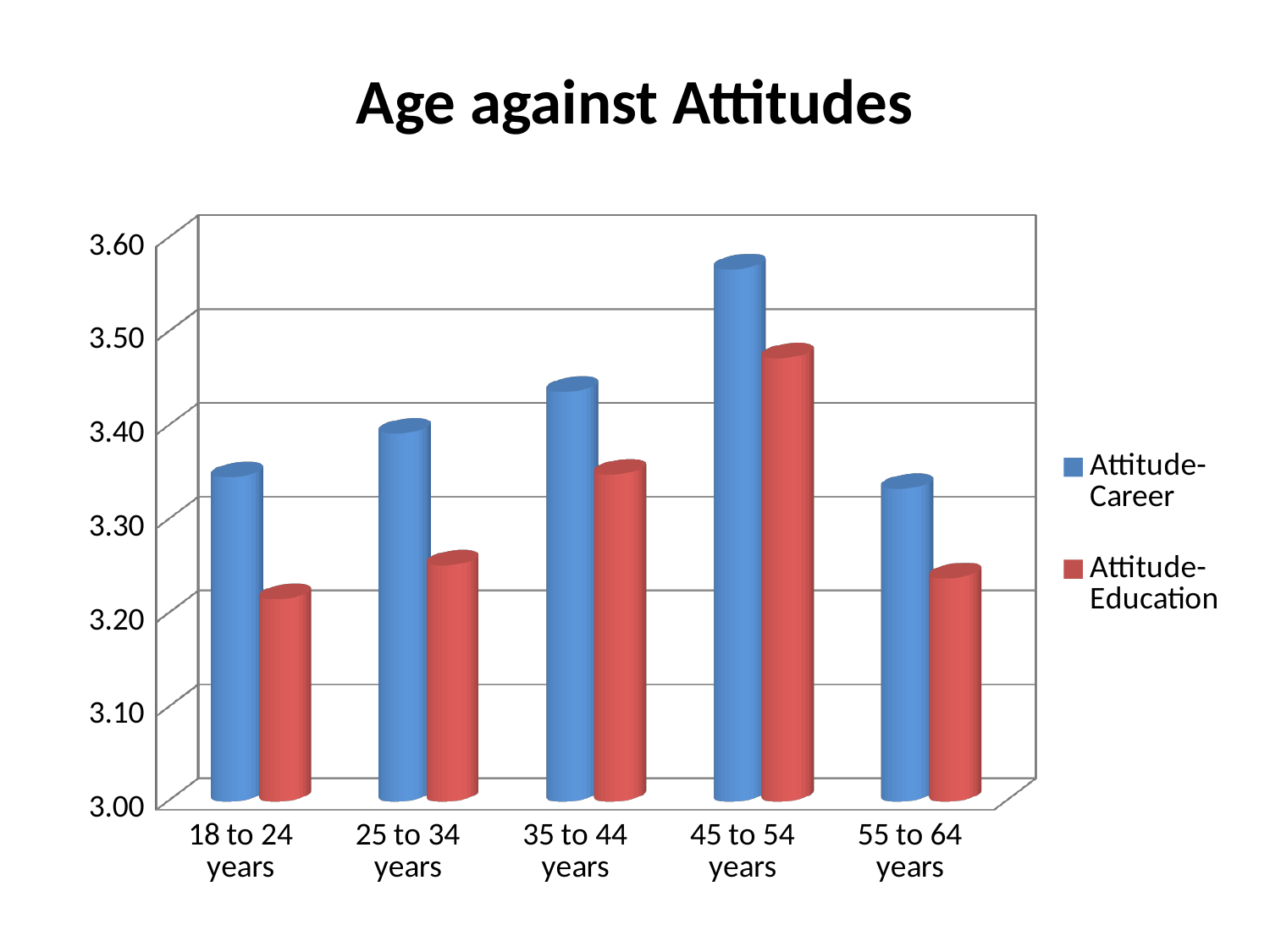
How many series does the legend list? 2 What kind of chart is shown on the slide? Bar chart Is the Attitude-Education value for 45 to 54 years greater or less than 3.40? greater Which age group has the highest Attitude-Education value? 45 to 54 years What is the title of the chart? Age against Attitudes Which age group has the highest Attitude-Career value? 45 to 54 years How many age groups are shown on the x axis? 5 Is the Attitude-Education value for 18 to 24 years greater or less than 3.30? less Which colour represents the Attitude-Education series? Red For 18 to 24 years, which is larger: Attitude-Career or Attitude-Education? Attitude-Career Is the Attitude-Career value for 35 to 44 years greater or less than 3.40? greater